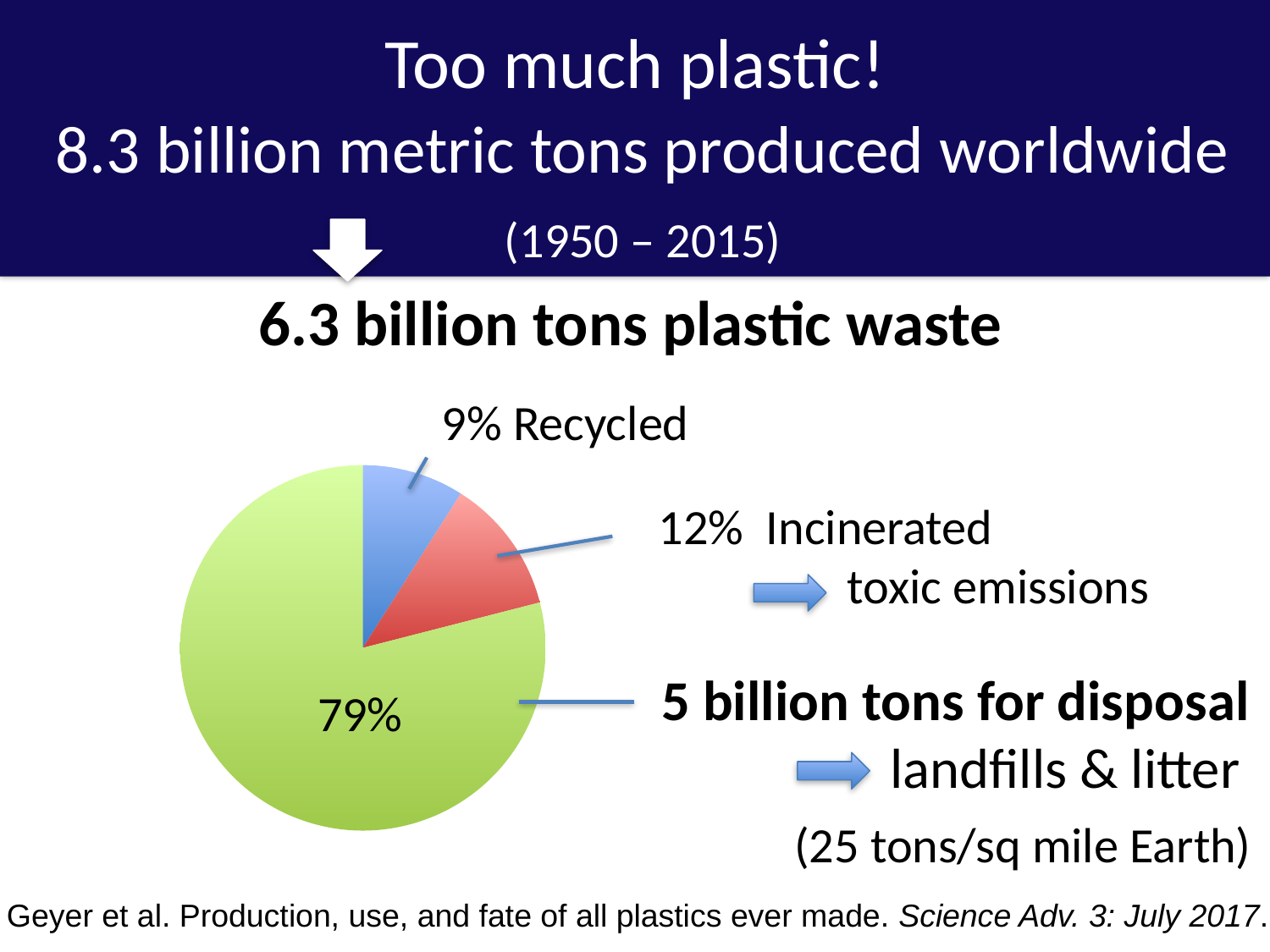
What kind of chart is shown on the slide? pie chart What colour is the slice representing the 12% incinerated share? red What percentage of plastic waste is incinerated according to the pie chart? 12% Which is larger, the recycled slice or the incinerated slice? Incinerated What is the difference in percentage points between the incinerated and recycled slices? 3 What percentage of plastic waste goes to disposal (landfills & litter) according to the pie chart? 79% What is the difference in percentage points between the disposal slice and the incinerated slice? 67 How many slices does the pie chart have? 3 What colour is the slice representing the 79% share for disposal? green Which slice of the pie chart is the smallest? 9% Recycled What percentage of plastic waste is recycled according to the pie chart? 9% Which slice of the pie chart is the largest? 79% (disposal / landfills & litter)